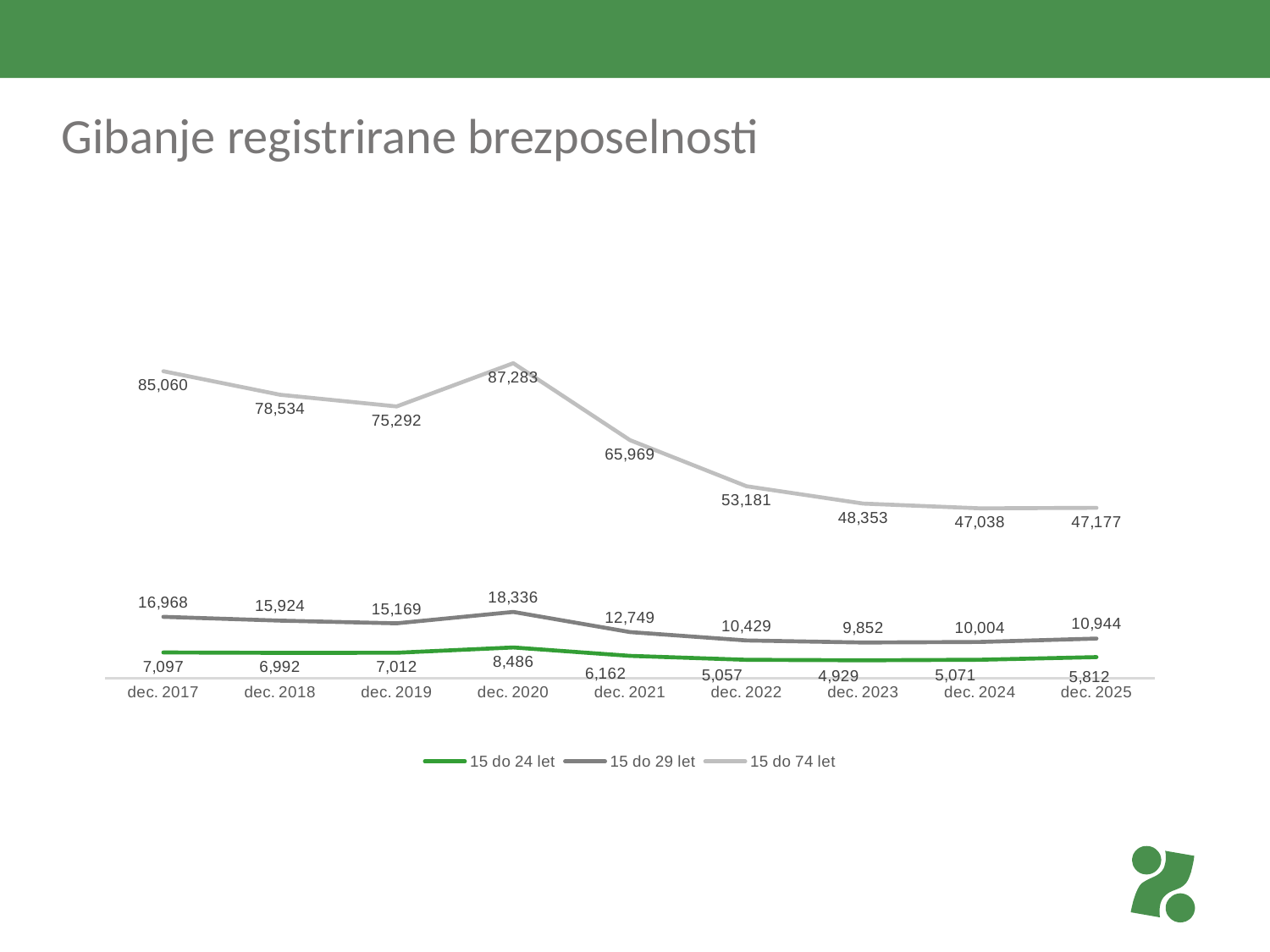
How many time periods are shown on the x axis? 9 How many series does the legend list? 3 What is the difference between the 15 do 29 let values in dec. 2017 and dec. 2025? 6,024 What is the value for the 15 do 74 let series in dec. 2020? 87,283 What is the value for the 15 do 29 let series in dec. 2025? 10,944 What is the difference between the 15 do 74 let values in dec. 2020 and dec. 2021? 21,314 In which period does the 15 do 74 let series reach its highest value? dec. 2020 In which period does the 15 do 24 let series reach its lowest value? dec. 2023 What kind of chart is shown on the slide? line chart What is the value for the 15 do 24 let series in dec. 2023? 4,929 Which is larger for the 15 do 29 let series: dec. 2018 or dec. 2019? dec. 2018 Does the 15 do 74 let series rise or fall from dec. 2020 to dec. 2024? fall